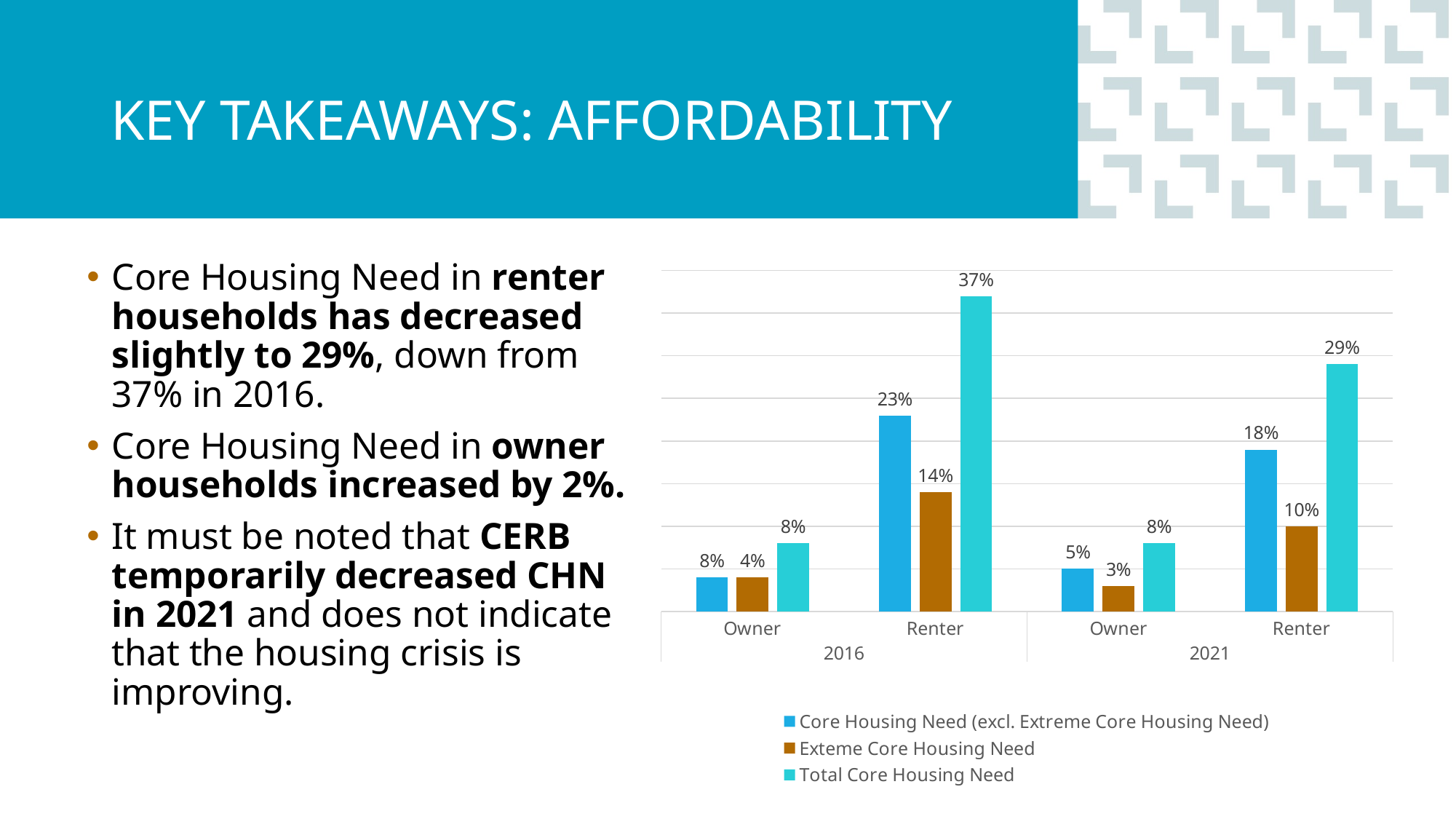
What is the Extreme Core Housing Need value for Renter households in 2016? 14% What is the difference between the Total Core Housing Need for Renter households in 2016 and in 2021? 8% Which is larger: the Core Housing Need (excl. Extreme Core Housing Need) for Renter households in 2016 or in 2021? 2016 What colour are the Total Core Housing Need bars? Light blue (cyan) What is the Extreme Core Housing Need value for Owner households in 2021? 3% Which category and year has the lowest Extreme Core Housing Need? Owner, 2021 What kind of chart is shown on the slide? Bar chart Which category and year has the highest Total Core Housing Need? Renter, 2016 What is the Total Core Housing Need for Renter households in 2016? 37% What is the Total Core Housing Need for Renter households in 2021? 29% What is the Core Housing Need (excl. Extreme Core Housing Need) value for Owner households in 2021? 5% How many series does the legend list? 3